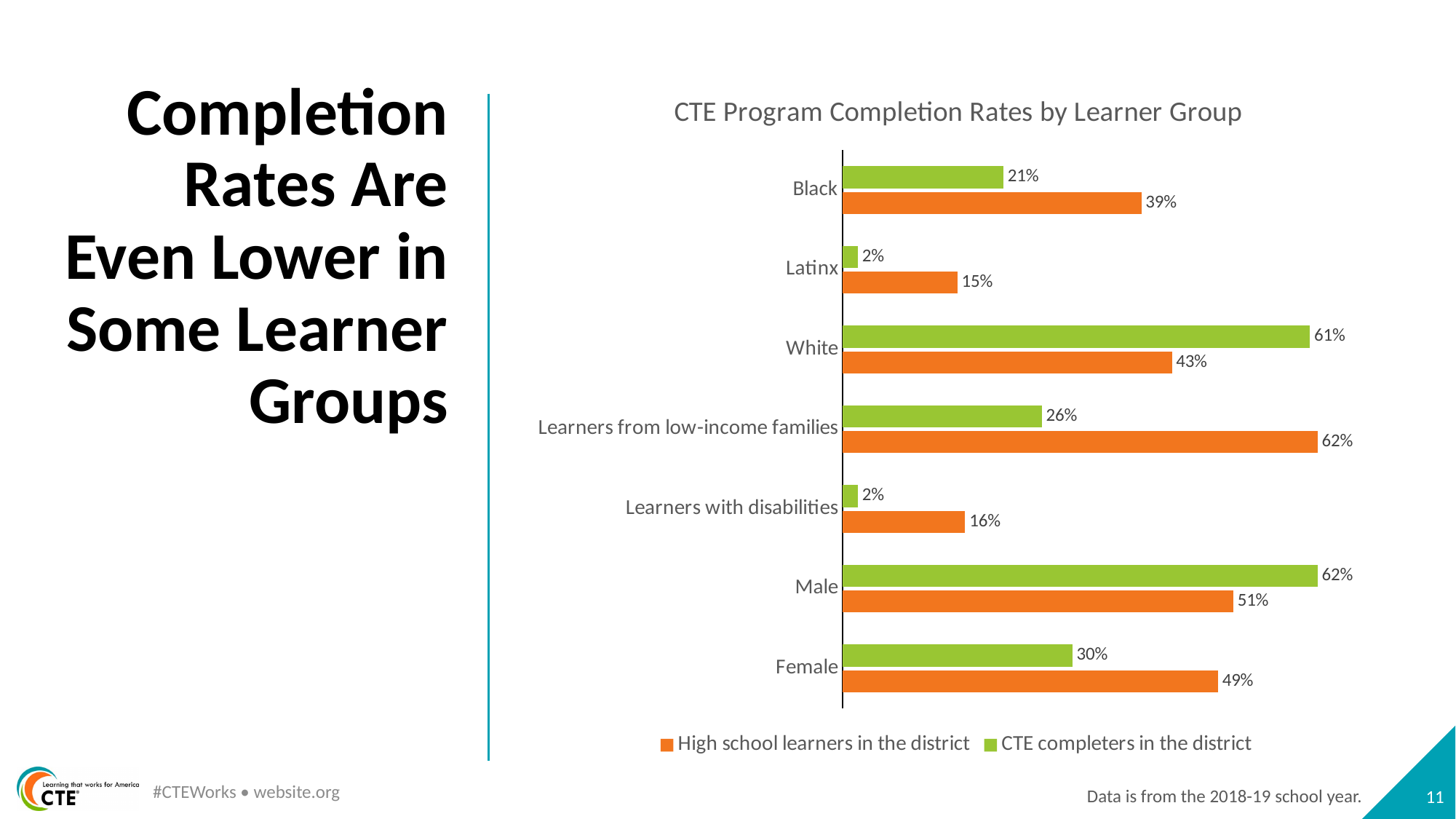
What is the title of the chart? CTE Program Completion Rates by Learner Group Which learner group has the lowest value for High school learners in the district? Latinx What kind of chart is shown on the slide? Bar chart What is the value for CTE completers in the district for Female learners? 30% What is the difference between the High school learners in the district value and the CTE completers in the district value for Black learners? 18% Which learner group has the highest value for CTE completers in the district? Male What is the value for CTE completers in the district for White learners? 61% How many series does the legend list? 2 Which is larger for Male learners: the High school learners in the district value or the CTE completers in the district value? CTE completers in the district How many learner groups are shown on the chart? 7 What is the value for High school learners in the district for Learners from low-income families? 62% Which colour represents CTE completers in the district? Green